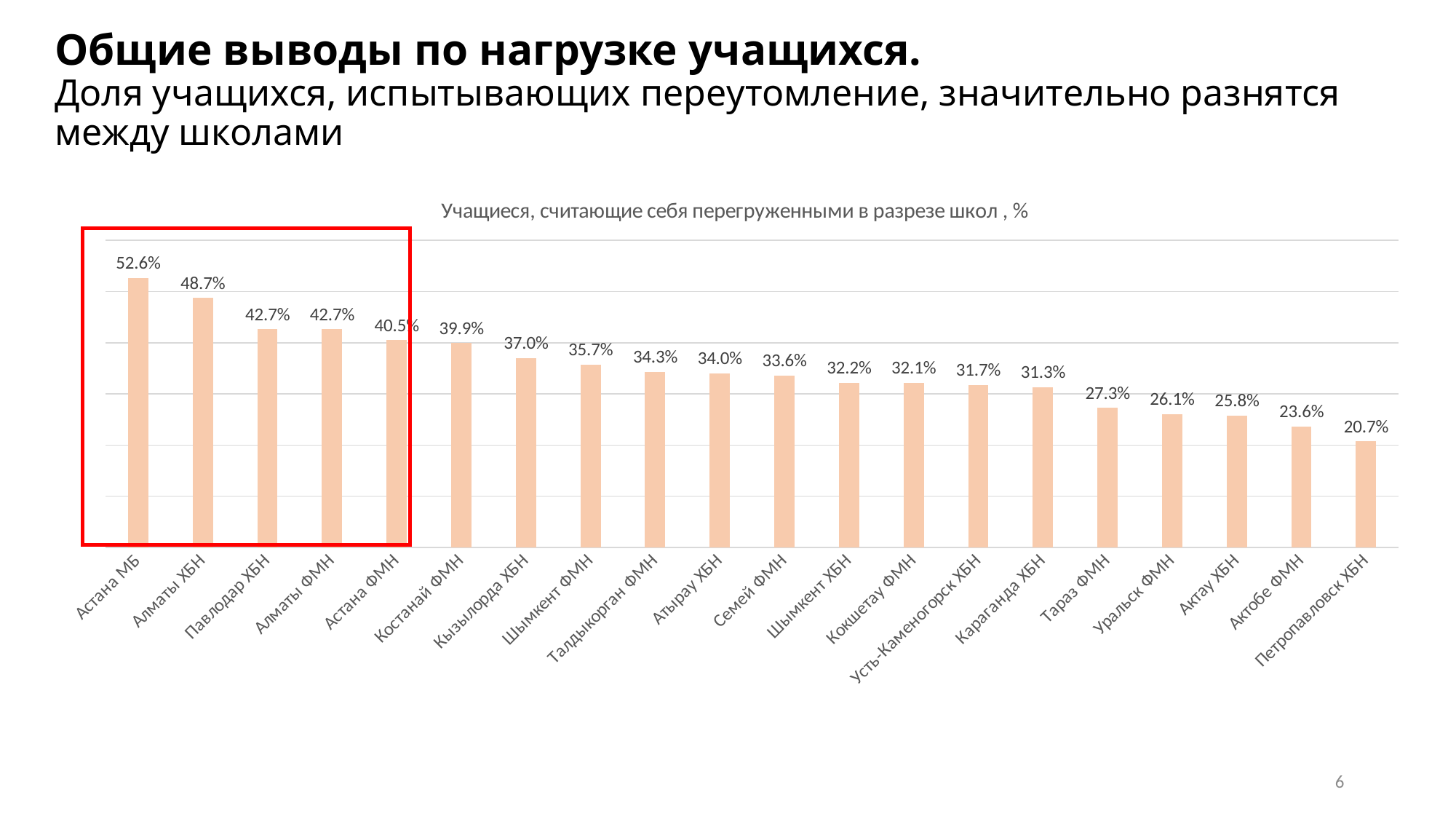
What is the difference between the highest and lowest values on the chart? 31.9 percentage points Do the values rise or fall from left to right along the x axis? Fall What is the value for Астана МБ? 52.6% What is the difference between the values for Астана МБ and Алматы ХБН? 3.9 percentage points How many schools are shown on the chart? 20 What is the value for Петропавловск ХБН? 20.7% Which school has the highest share of students who consider themselves overloaded? Астана МБ Which school has the lowest share of students who consider themselves overloaded? Петропавловск ХБН Which is larger, the value for Костанай ФМН or the value for Шымкент ФМН? Костанай ФМН What kind of chart is shown on the slide? Bar chart What is the value for Тараз ФМН? 27.3% What is the value for Кызылорда ХБН? 37.0%